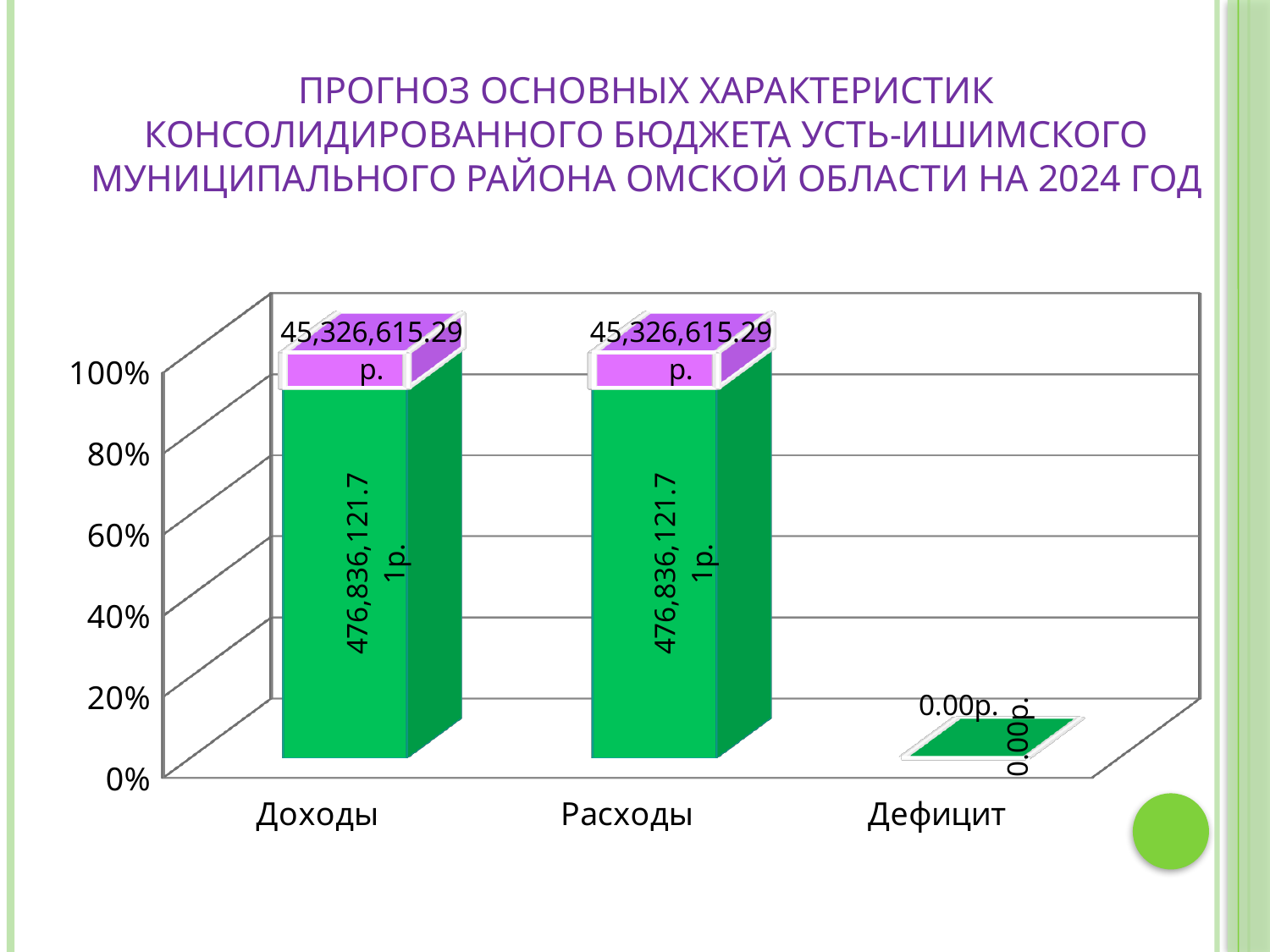
What is the value of the purple segment for Расходы? 45,326,615.29р. What is the value of the purple segment for Доходы? 45,326,615.29р. What is the value shown for Дефицит? 0.00р. What is the difference between the green and purple segments for Расходы? 431,509,506.42р. Which is larger: the green segment for Доходы or the value for Дефицит? Доходы What kind of chart is shown on the slide? Stacked bar chart What is the total of the stacked bar for Доходы? 522,162,737.00р. What is the highest tick label on the vertical axis? 100% What is the value of the green segment for Доходы? 476,836,121.71р. What is the value of the green segment for Расходы? 476,836,121.71р. How many categories are shown on the x axis? 3 Which category has the lowest value? Дефицит